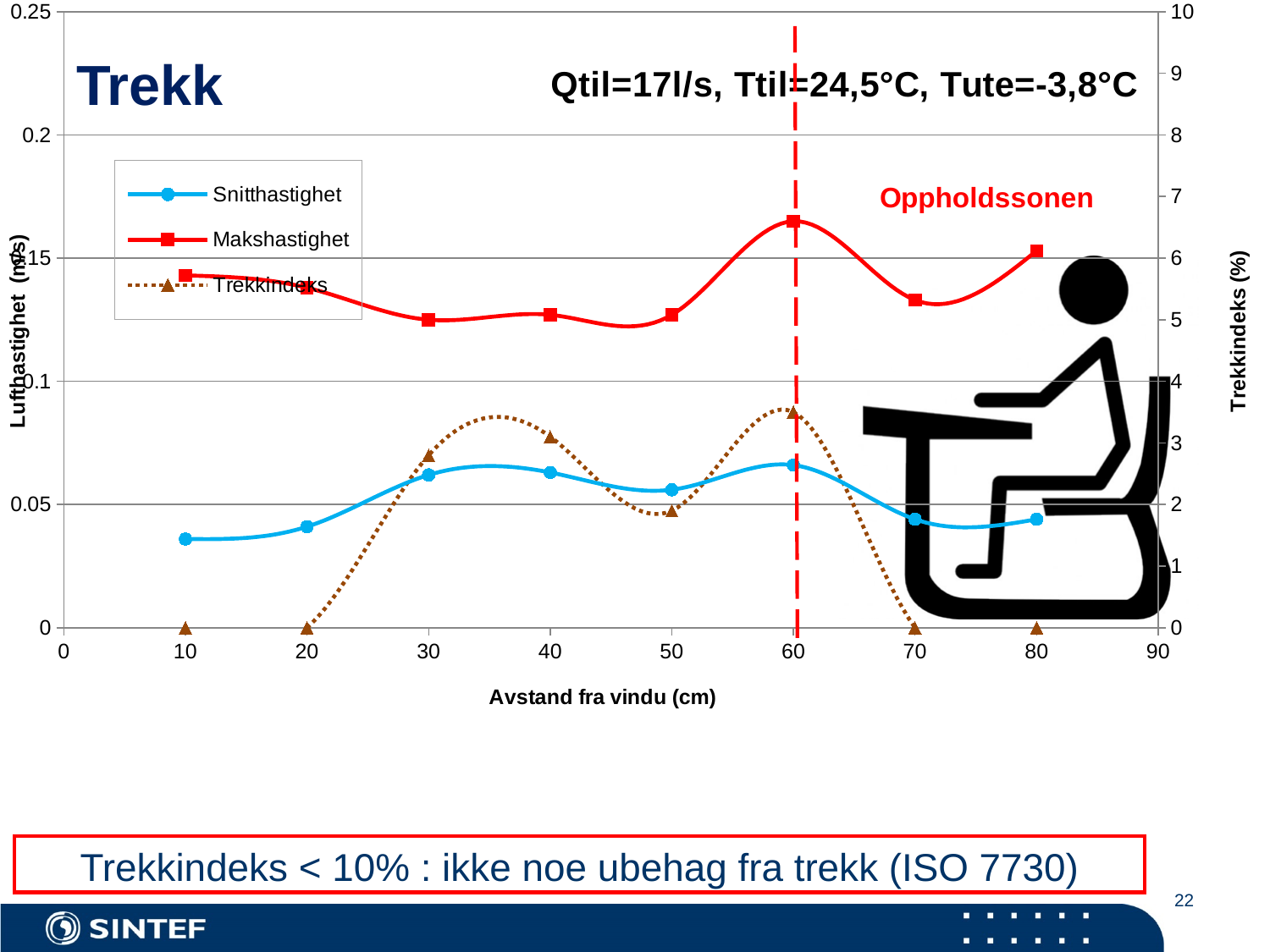
Is the Snitthastighet value at 10 cm greater or less than 0.05? less What is the Trekkindeks value at 10 cm from the window? 0 At which distance from the window is Trekkindeks highest? 60 cm What is the title of the x axis? Avstand fra vindu (cm) At which distance from the window (Avstand fra vindu) is Makshastighet highest? 60 cm Is the Makshastighet value at 60 cm greater or less than 0.15? greater Is the Trekkindeks value at 60 cm greater or less than 3 on the right axis? greater What is the Trekkindeks value at 70 cm from the window? 0 Which is larger: Makshastighet at 60 cm or Makshastighet at 70 cm? Makshastighet at 60 cm How many series does the chart legend list? 3 What kind of chart is shown on the slide? line chart How many data points does the Makshastighet series have? 8